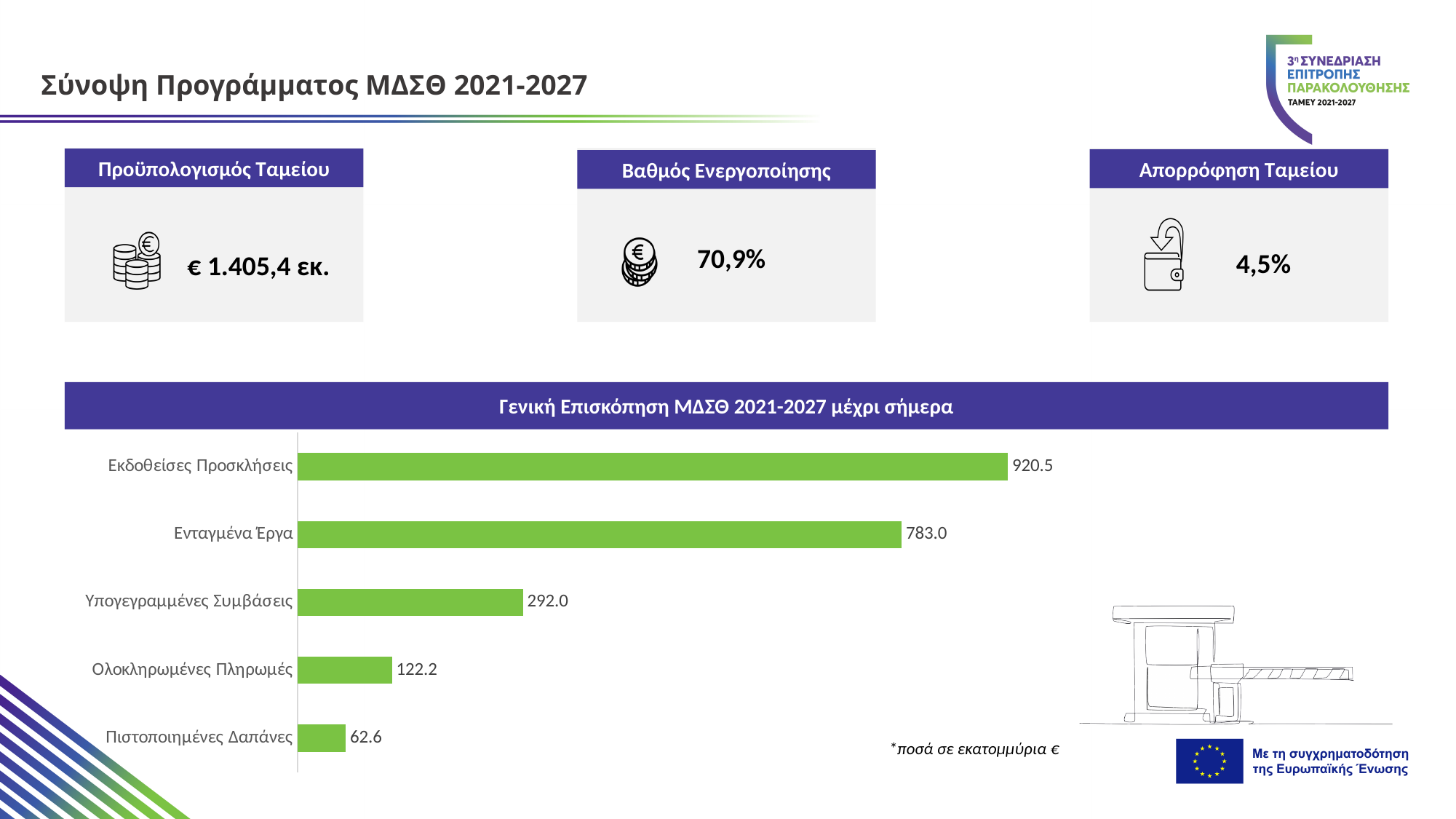
What is the difference between the values for Εκδοθείσες Προσκλήσεις and Ενταγμένα Έργα? 137.5 What is the value for Υπογεγραμμένες Συμβάσεις? 292.0 What is the value for Πιστοποιημένες Δαπάνες? 62.6 Which is larger, the value for Υπογεγραμμένες Συμβάσεις or the value for Ολοκληρωμένες Πληρωμές? Υπογεγραμμένες Συμβάσεις Which category has the lowest value? Πιστοποιημένες Δαπάνες What kind of chart is shown on the slide? Bar chart What is the title of the chart? Γενική Επισκόπηση ΜΔΣΘ 2021-2027 μέχρι σήμερα How many categories are shown in the chart? 5 What is the value for Εκδοθείσες Προσκλήσεις? 920.5 What is the value for Ενταγμένα Έργα? 783.0 Which category has the highest value? Εκδοθείσες Προσκλήσεις What is the value for Ολοκληρωμένες Πληρωμές? 122.2